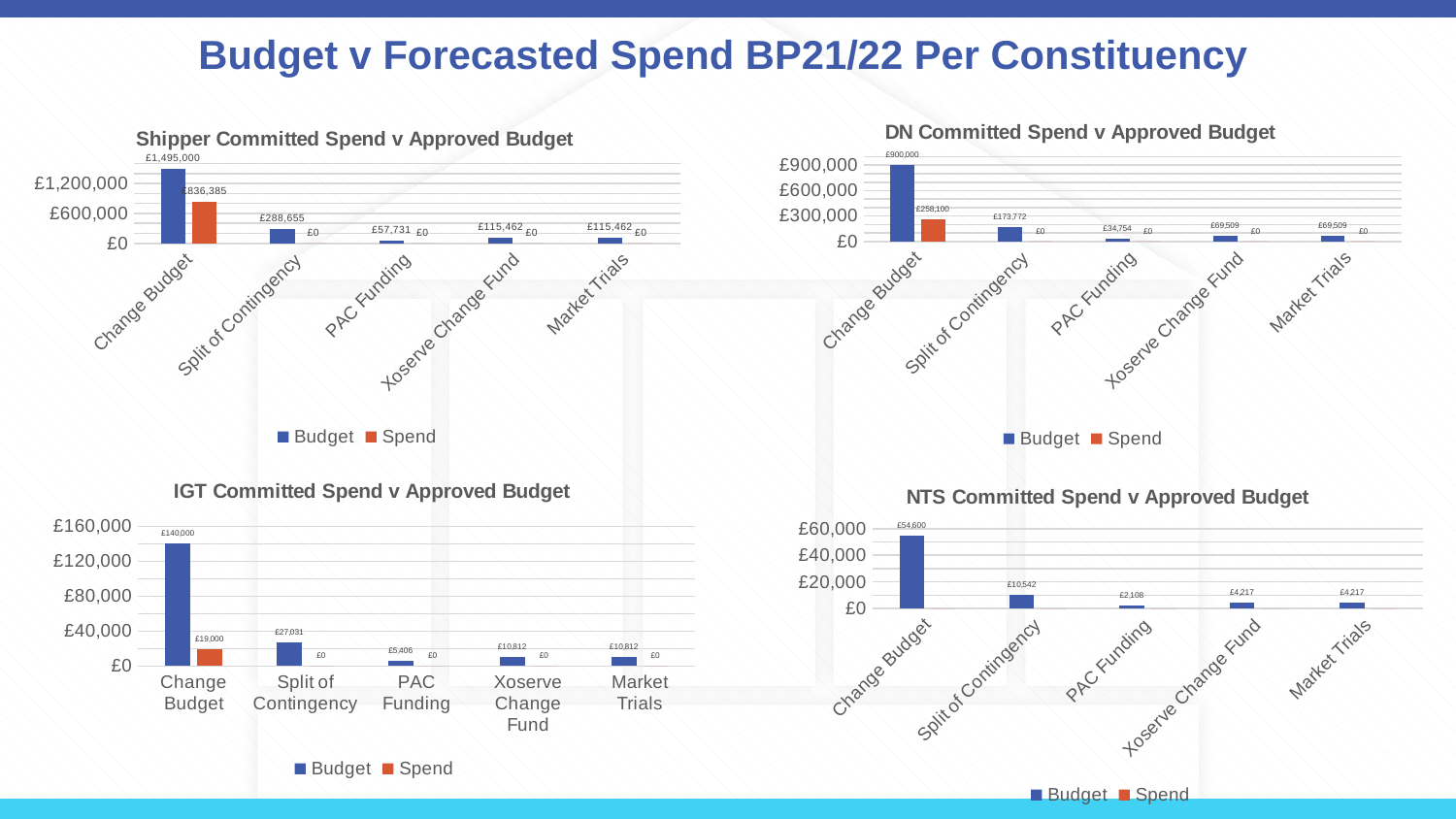
In the IGT Committed Spend v Approved Budget chart, what is the Spend value for Change Budget? £19,000 In the Shipper Committed Spend v Approved Budget chart, what is the Budget value for Change Budget? £1,495,000 How many categories are shown on the x axis of the IGT Committed Spend v Approved Budget chart? 5 In the NTS Committed Spend v Approved Budget chart, which category has the highest Budget value? Change Budget In the Shipper Committed Spend v Approved Budget chart, what is the Spend value for Change Budget? £836,385 How many series does the legend of the DN Committed Spend v Approved Budget chart list? 2 In the Shipper Committed Spend v Approved Budget chart, what is the difference between the Budget and Spend values for Change Budget? £658,615 In the DN Committed Spend v Approved Budget chart, which category has the lowest Budget value? PAC Funding In the NTS Committed Spend v Approved Budget chart, what is the Budget value for Change Budget? £54,600 In the NTS Committed Spend v Approved Budget chart, is the Budget value for Split of Contingency greater or less than £20,000? less In the DN Committed Spend v Approved Budget chart, what is the Budget value for Split of Contingency? £173,772 In the IGT Committed Spend v Approved Budget chart, what is the Budget value for PAC Funding? £5,406